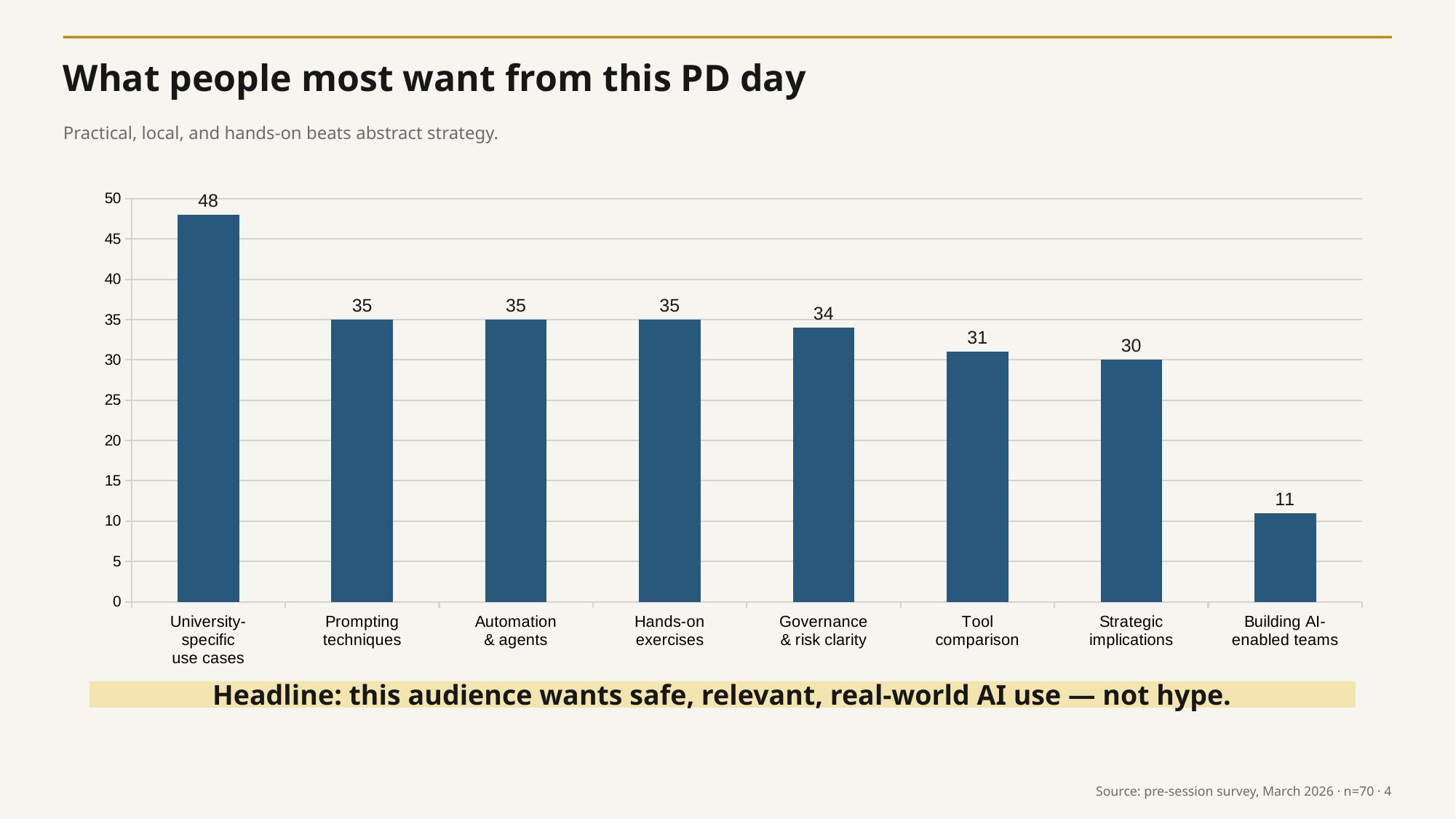
What kind of chart is shown on the slide? Bar chart How many categories are shown in the chart? 8 What is the value for University-specific use cases? 48 Which category has the lowest value? Building AI-enabled teams What is the value for Governance & risk clarity? 34 What is the value for Strategic implications? 30 What is the difference between University-specific use cases and Tool comparison? 17 What is the value for Building AI-enabled teams? 11 What is the difference between Strategic implications and Building AI-enabled teams? 19 Which is larger, Governance & risk clarity or Tool comparison? Governance & risk clarity Which category has the highest value? University-specific use cases What is the title of the slide? What people most want from this PD day